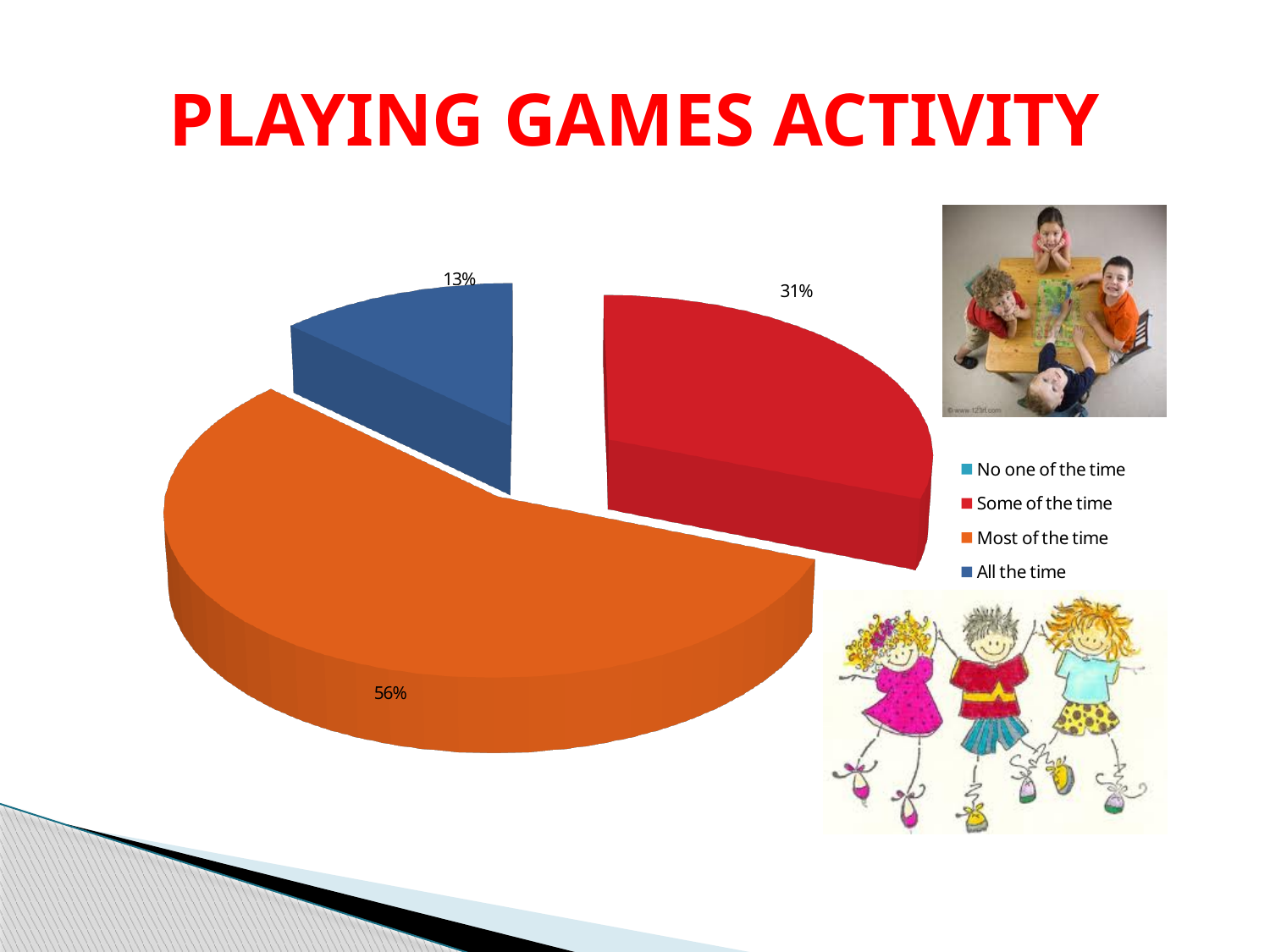
Which is larger, the slice for "Some of the time" or the slice for "All the time"? Some of the time What percentage is shown for "All the time"? 13% What percentage is shown for "Most of the time"? 56% What is the title of the slide containing the chart? PLAYING GAMES ACTIVITY What kind of chart is shown on the slide? pie chart What colour is the slice for "Most of the time"? orange How many entries does the legend list? 4 What percentage is shown for "Some of the time"? 31% How many slices with data labels are visible in the pie? 3 Which category has the largest slice of the pie? Most of the time What is the difference in percentage points between "Most of the time" and "Some of the time"? 25 Which labelled slice is the smallest in the pie? All the time